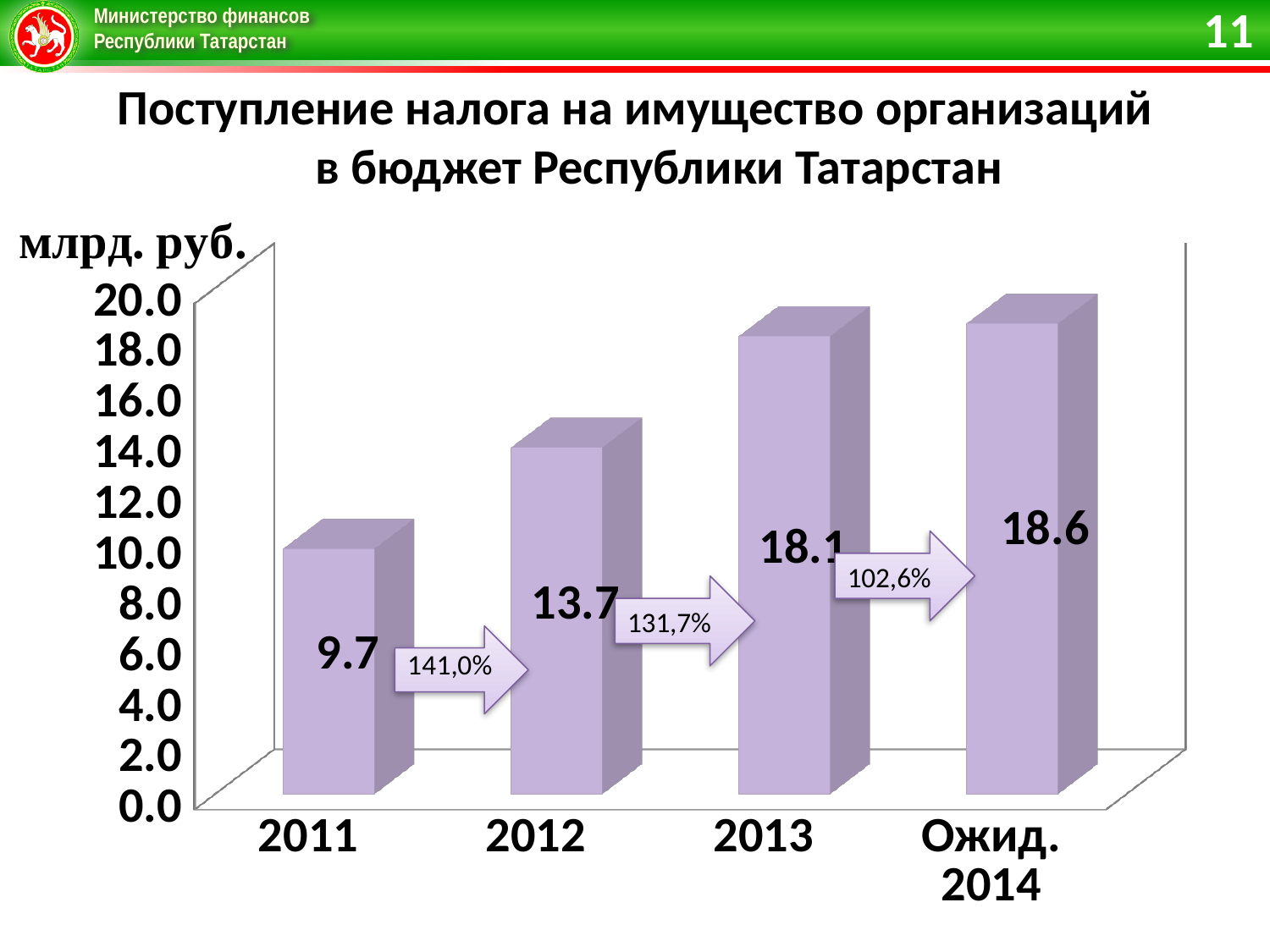
Which category has the highest value? Ожид. 2014 What is the value for 2012? 13.7 Which year has the lowest value? 2011 What is the value for 2013? 18.1 How many categories are shown on the x axis? 4 What is the value for 2011? 9.7 Which is larger, the value for 2013 or the value for 2012? 2013 Do the values rise or fall from 2011 to Ожид. 2014? rise What is the expected value for 2014 (Ожид. 2014)? 18.6 What growth percentage is shown on the arrow between 2011 and 2012? 141,0% What kind of chart is shown on the slide? bar chart What is the difference between the values for 2012 and 2011? 4.0